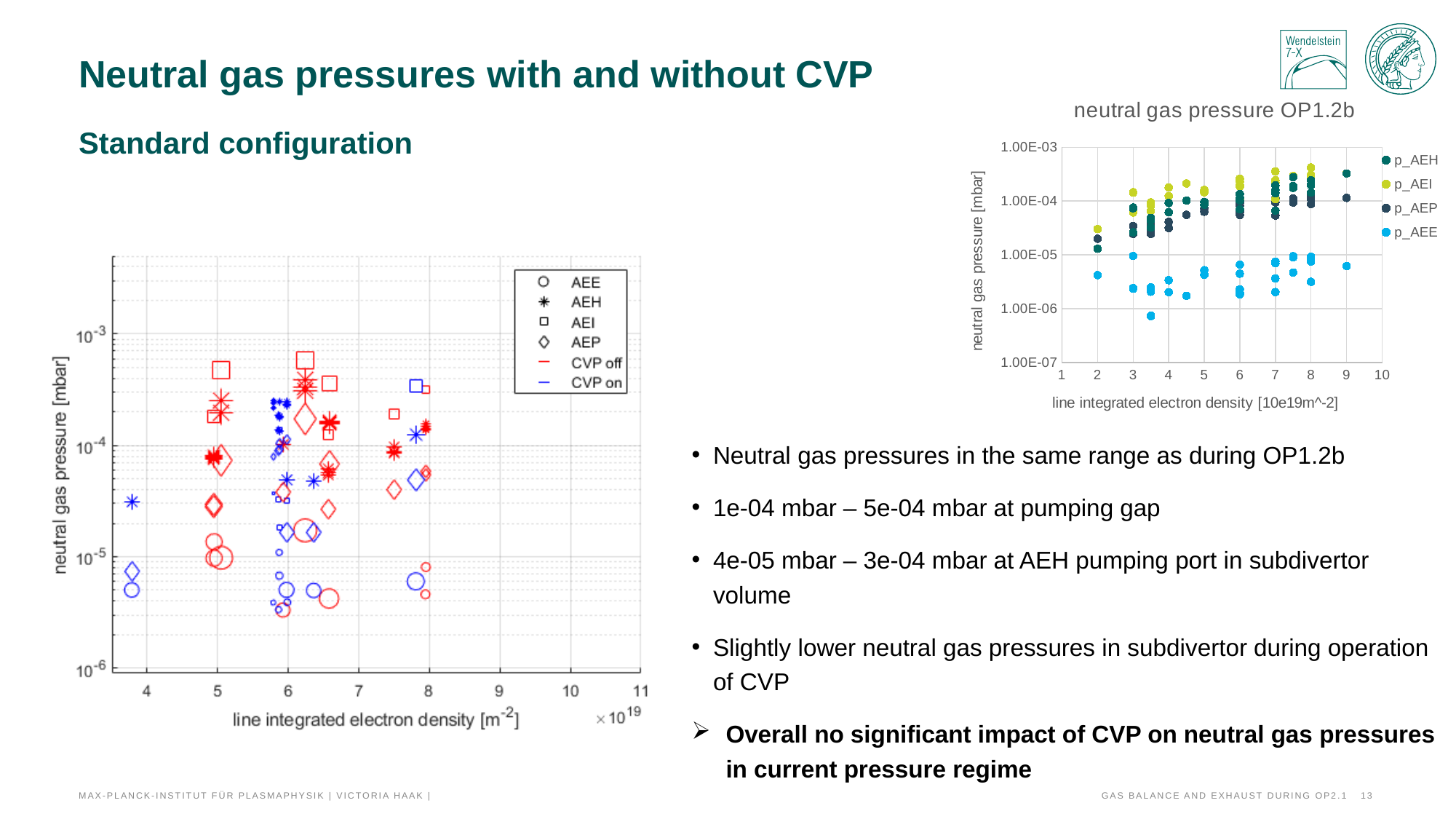
In the right chart 'neutral gas pressure OP1.2b', is the highest p_AEI value at a line integrated electron density of 7 greater or less than 1.00E-04? greater In the right chart 'neutral gas pressure OP1.2b', do the p_AEI values generally rise or fall as line integrated electron density increases from 2 to 8? rise In the right chart 'neutral gas pressure OP1.2b', is the p_AEE value at a line integrated electron density of 2 greater or less than 1.00E-05? less In the right chart 'neutral gas pressure OP1.2b', which series has the lowest pressure values? p_AEE What kind of chart is the right chart titled 'neutral gas pressure OP1.2b'? scatter plot In the left chart, which colour represents 'CVP on'? blue In the right chart 'neutral gas pressure OP1.2b', at a line integrated electron density of 6, which series has larger values: p_AEI or p_AEE? p_AEI How many series does the legend of the right chart 'neutral gas pressure OP1.2b' list? 4 How many entries does the legend of the left chart list? 6 What kind of chart is the left chart on the slide? scatter plot In the left chart, which series (marker type) has the lowest neutral gas pressures overall? AEE What is the title of the right chart? neutral gas pressure OP1.2b